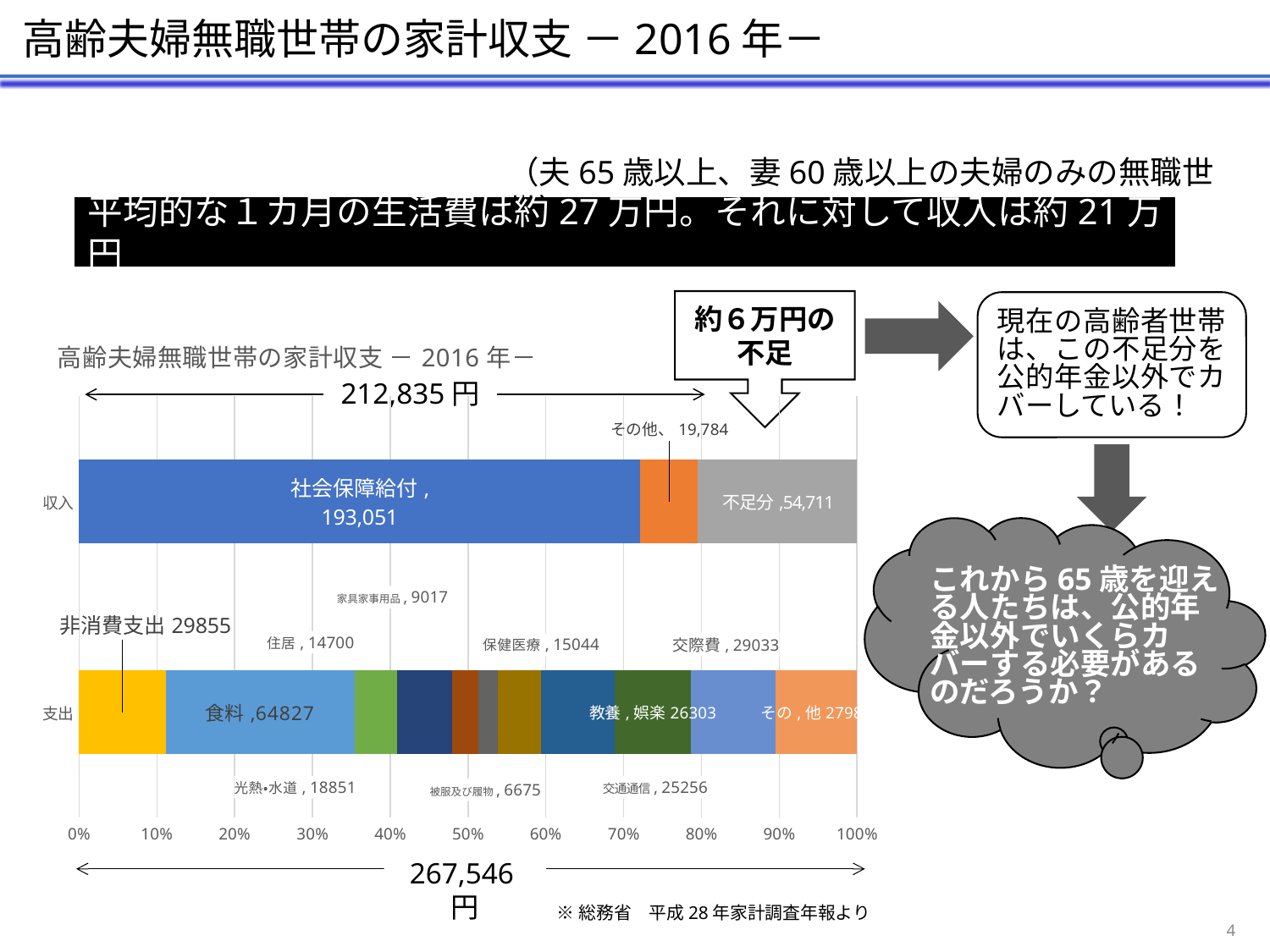
What is the value of 交際費 in the 支出 bar? 29033 Is the share of 社会保障給付 in the 収入 bar greater or less than 80%? less What is the value of 不足分 in the 収入 bar? 54,711 What is the value of 住居 in the 支出 bar? 14700 What is the difference between 社会保障給付 and 不足分 in the 収入 bar? 138,340 Which segment is the largest in the 支出 bar? 食料 How many bars (categories) are shown on the chart's vertical axis? 2 What is the value of 社会保障給付 in the 収入 bar? 193,051 What is the value of 食料 in the 支出 bar? 64827 Which is larger in the 支出 bar, 交通通信 or 教養娯楽? 教養娯楽 What kind of chart is shown on the slide? Stacked bar chart Which is larger in the 支出 bar, 保健医療 or 住居? 保健医療